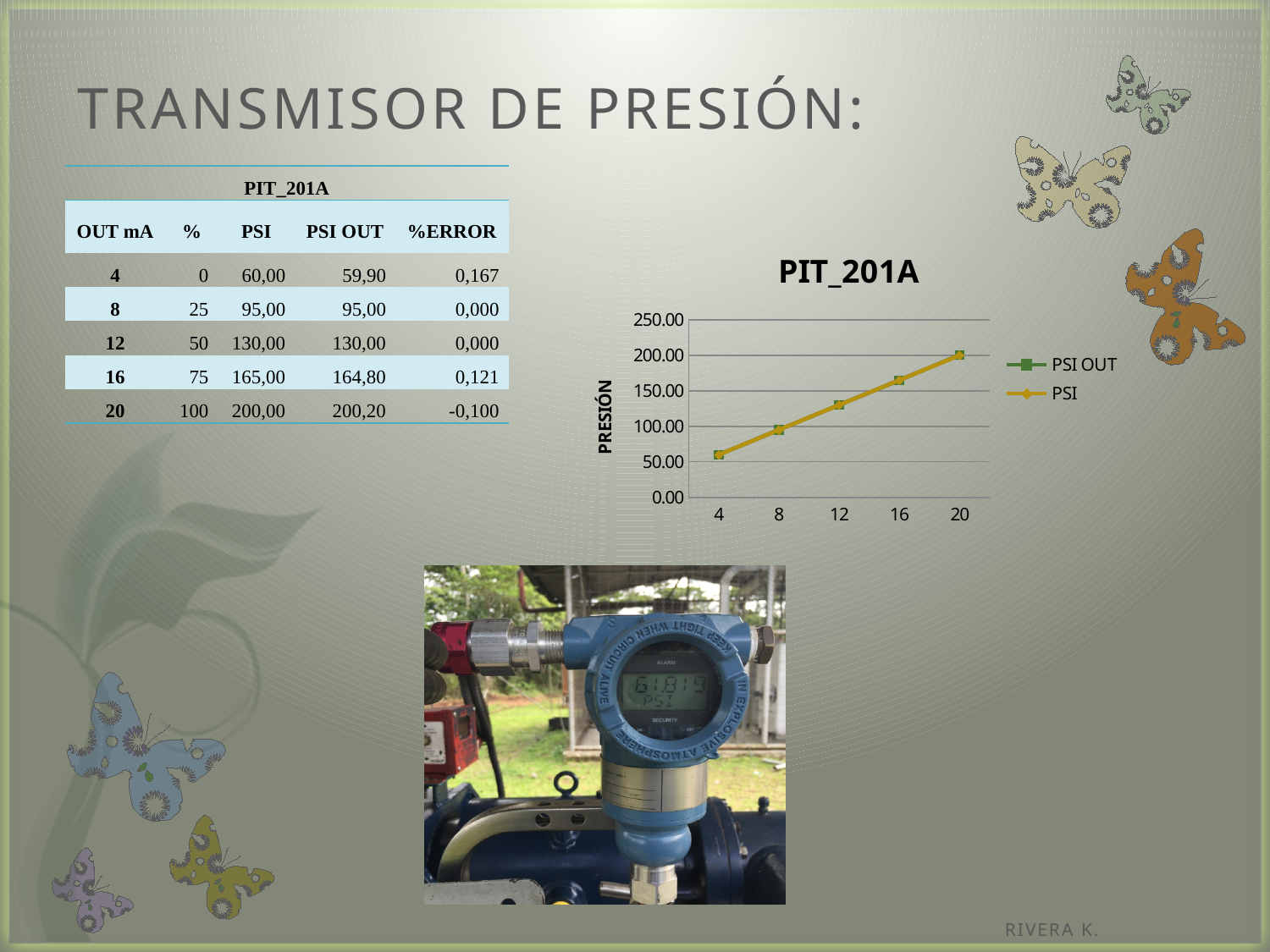
On the PIT_201A chart, at which x value is the PSI series highest? 20 On the PIT_201A chart, is the PSI value at x = 4 greater or less than 100.00? less On the PIT_201A chart, at which x value is the PSI OUT series lowest? 4 How many series does the legend of the PIT_201A chart list? 2 On the PIT_201A chart, is the PSI value at x = 12 greater or less than 100.00? greater Do the PSI values rise or fall as the x axis goes from 4 to 20 on the PIT_201A chart? rise How many points are plotted along the x axis of the PIT_201A chart? 5 What are the two series named in the legend of the PIT_201A chart? PSI OUT and PSI What kind of chart is shown under the title PIT_201A? line chart What is the label of the y axis on the PIT_201A chart? PRESIÓN On the PIT_201A chart, is the PSI OUT value at x = 16 greater or less than 150.00? greater